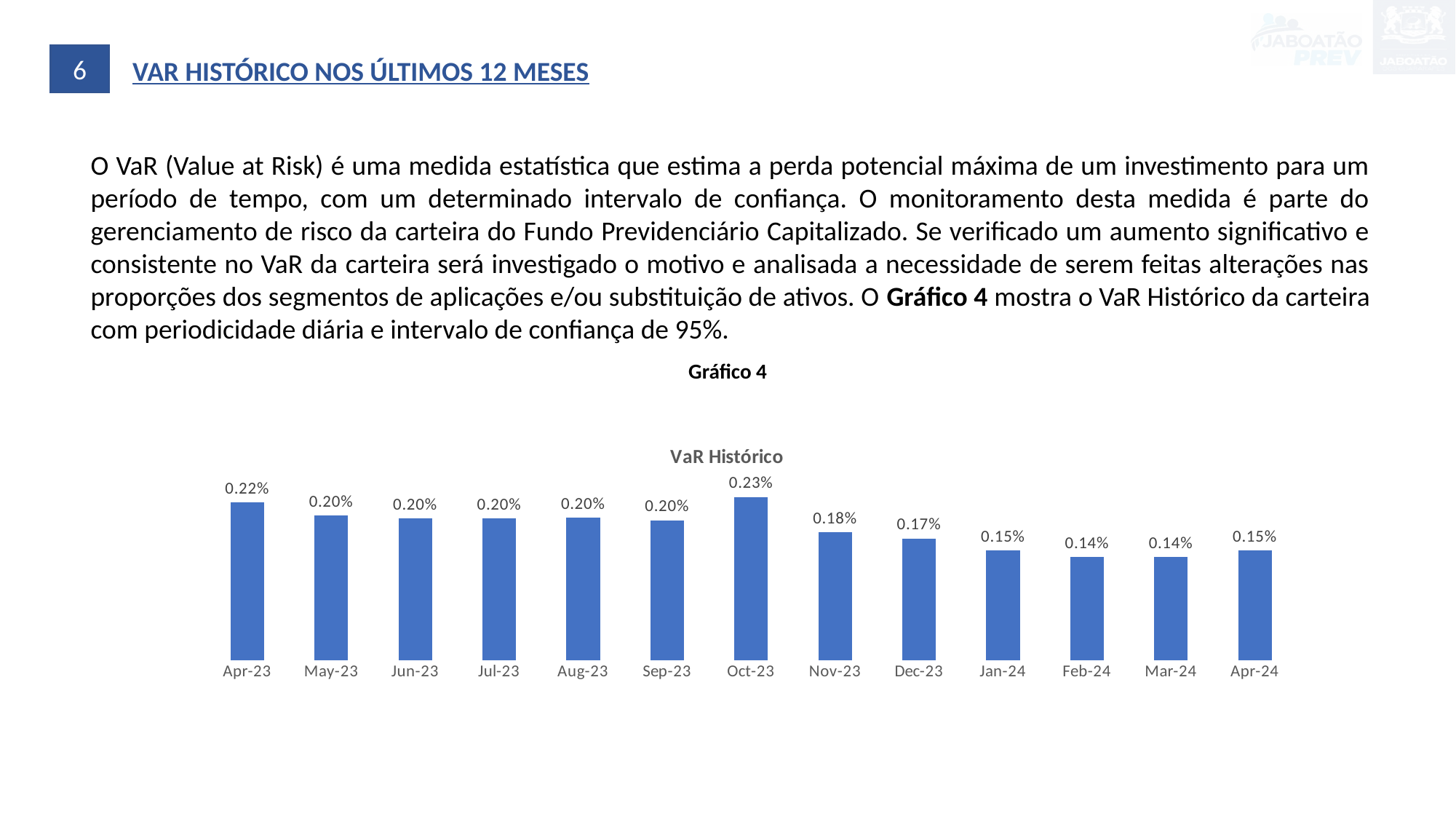
What is the VaR value for Apr-24? 0.15% What kind of chart is used to show the VaR Histórico? Bar chart What is the difference between the VaR values for Apr-23 and Nov-23? 0.04% Do the VaR values rise or fall from Oct-23 to Mar-24? Fall What is the lowest VaR value shown in the chart? 0.14% Which has a larger VaR value, Apr-23 or Apr-24? Apr-23 How many months are shown in the chart? 13 What is the VaR value for Oct-23? 0.23% What is the VaR value for Apr-23? 0.22% What is the difference between the VaR values for Oct-23 and Apr-24? 0.08% Which month has the highest VaR value? Oct-23 What is the VaR value for Dec-23? 0.17%